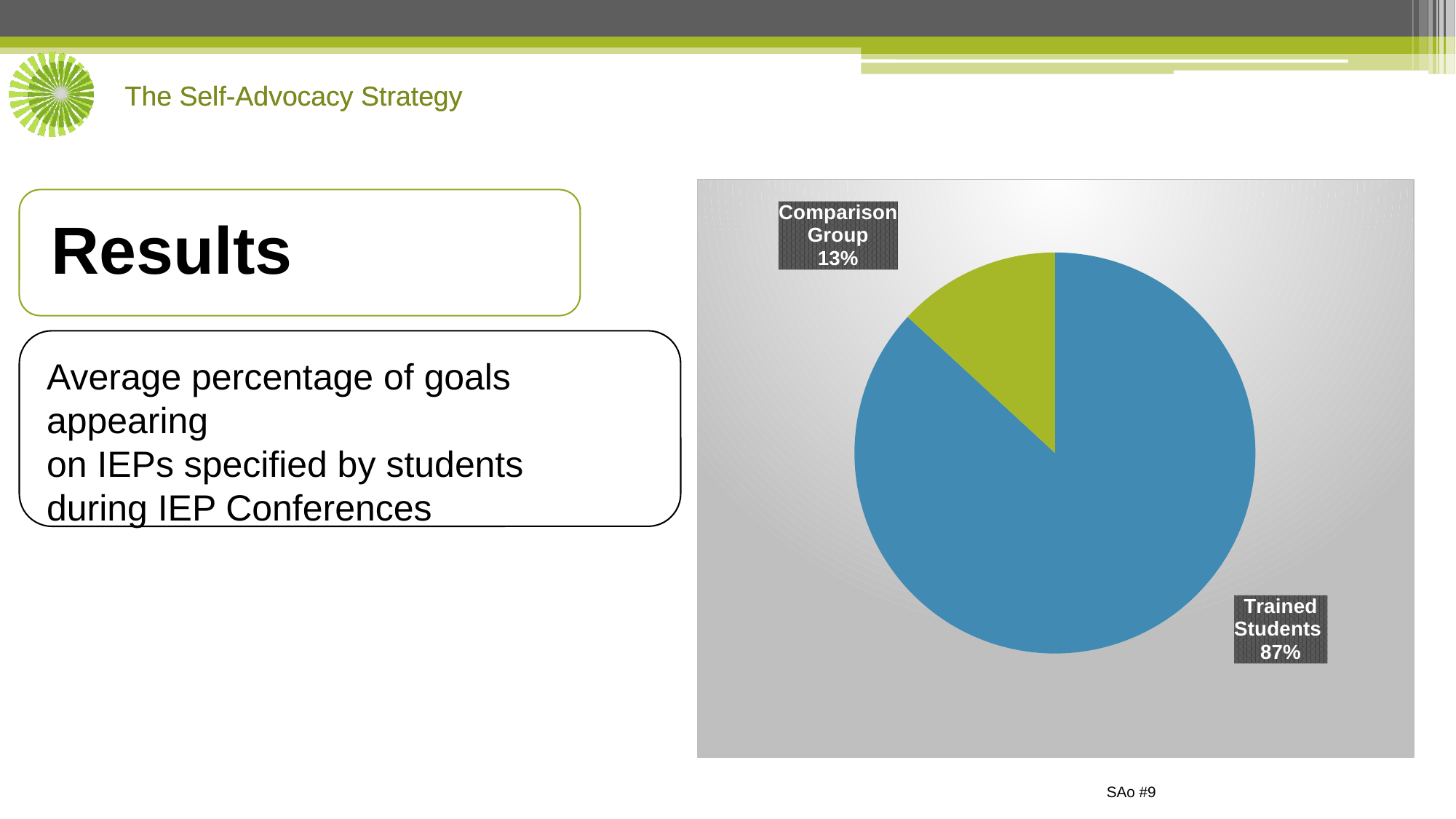
What percentage is shown for the Comparison Group? 13% What percentage is shown for Trained Students? 87% What colour is the Comparison Group slice? green What kind of chart is shown on the slide? pie chart How many slices does the pie chart have? 2 What is the difference in percentage points between Trained Students and the Comparison Group? 74 Which is larger, the Trained Students slice or the Comparison Group slice? Trained Students What colour is the Trained Students slice? blue Which slice of the pie is the smallest? Comparison Group Which slice of the pie is the largest? Trained Students What share of the pie does the Comparison Group slice represent? 13%